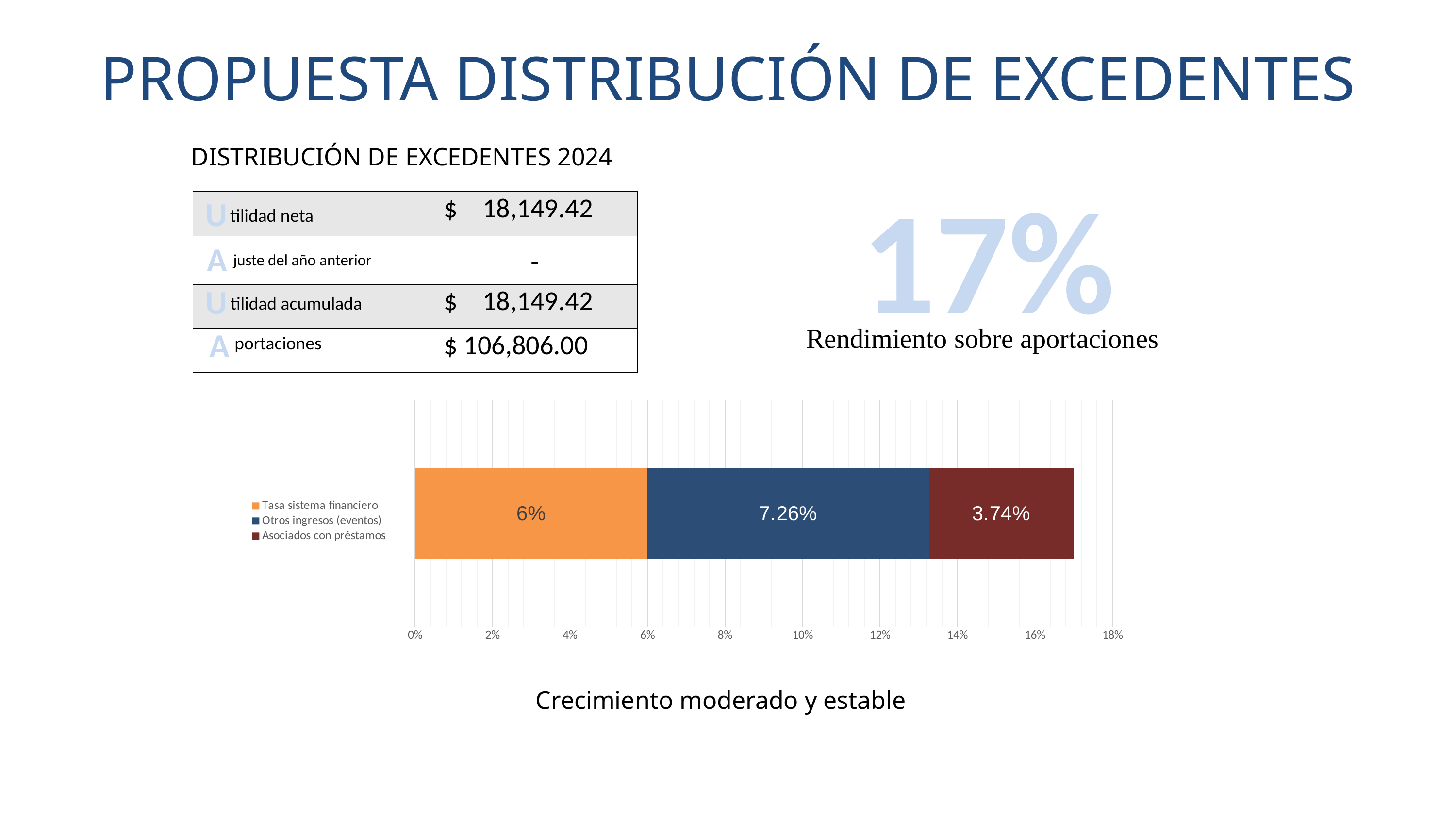
Which series has the lowest value in the chart? Asociados con préstamos What is the difference between Otros ingresos (eventos) and Asociados con préstamos? 3.52% Is the total of the stacked bar greater or less than 16%? greater What kind of chart is shown on the slide? Stacked bar chart What is the value for Asociados con préstamos? 3.74% What is the value for Tasa sistema financiero? 6% Which is larger, Tasa sistema financiero or Otros ingresos (eventos)? Otros ingresos (eventos) How many series does the chart legend list? 3 What is the total of the stacked bar? 17% Which series has the highest value in the chart? Otros ingresos (eventos) What is the value for Otros ingresos (eventos)? 7.26% What colour represents Tasa sistema financiero in the chart? Orange